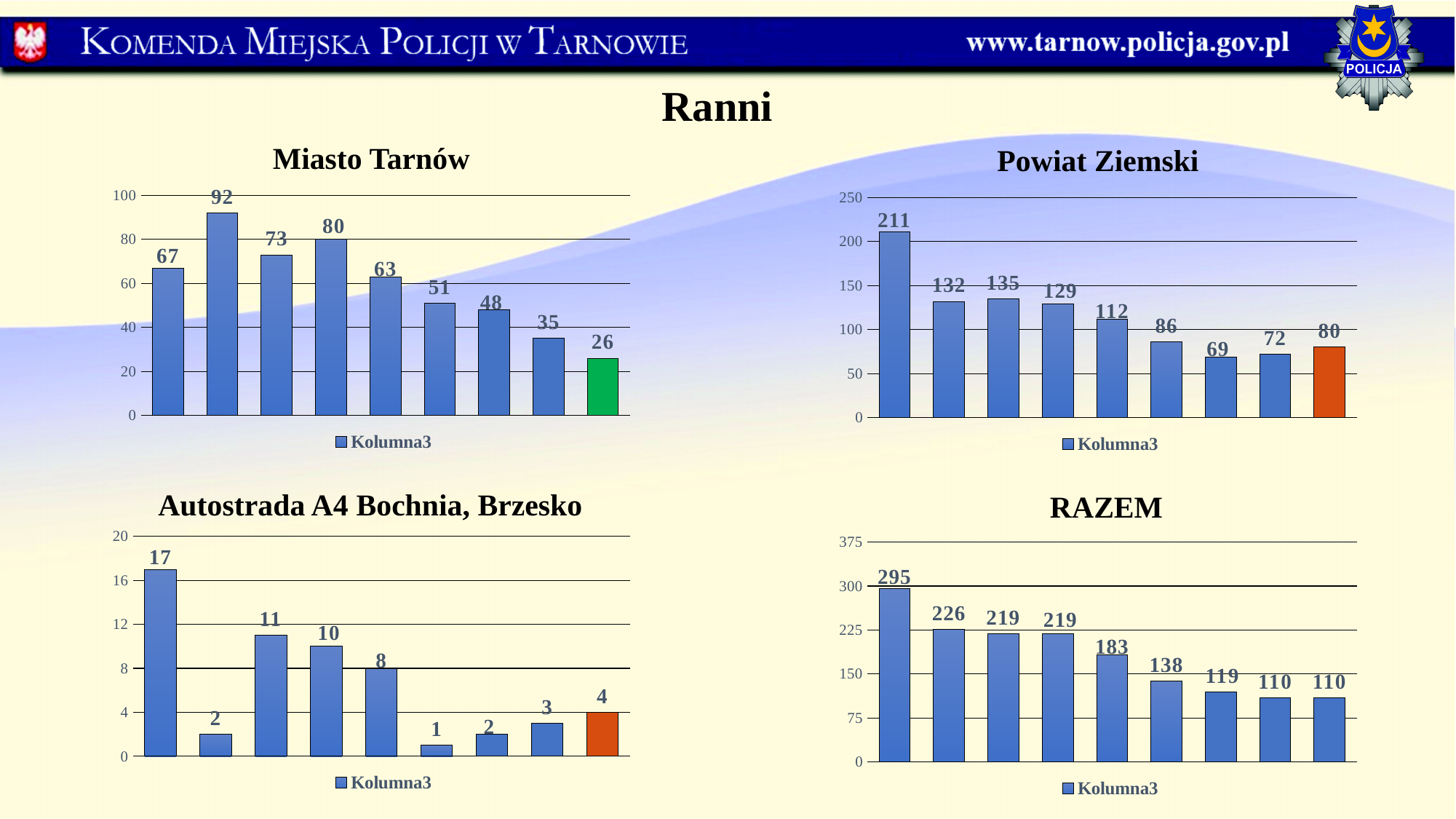
In the Miasto Tarnów chart, what is the difference between the first bar (67) and the last bar (26)? 41 In the Powiat Ziemski chart, what is the value of the last (orange) bar? 80 In the Powiat Ziemski chart, what is the value of the first bar? 211 In the Miasto Tarnów chart, what is the value of the last (green) bar? 26 What type of chart is the Miasto Tarnów chart? bar chart In the RAZEM chart, is the first bar (295) larger or smaller than the second bar (226)? larger In the RAZEM chart, what is the value of the first bar? 295 In the Autostrada A4 Bochnia, Brzesko chart, what is the highest value shown? 17 In the Miasto Tarnów chart, what is the highest value shown? 92 In the Autostrada A4 Bochnia, Brzesko chart, what is the lowest value shown? 1 How many bars does the RAZEM chart contain? 9 In the Powiat Ziemski chart, what is the lowest value shown? 69